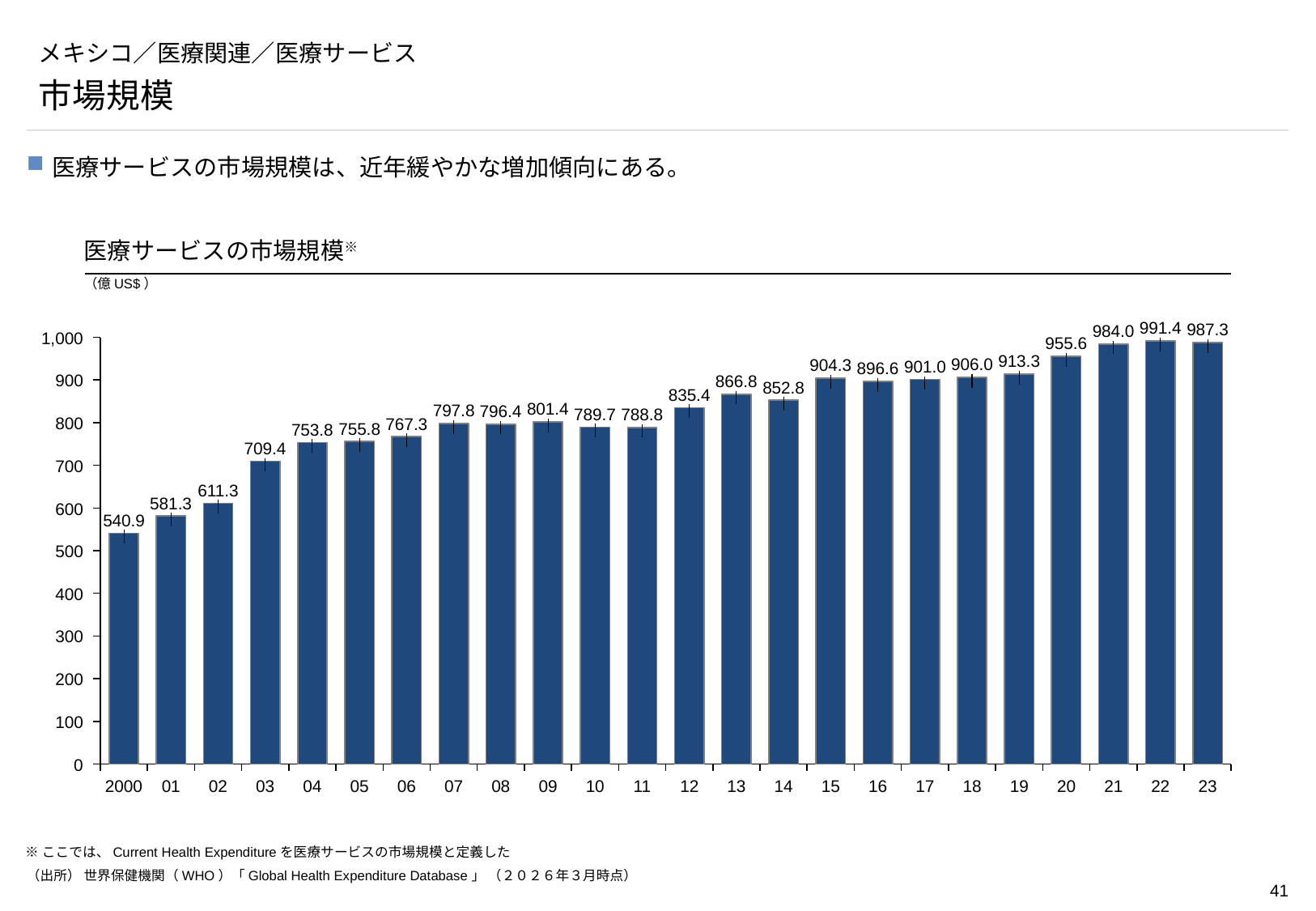
What is the difference between the values for 23 and 2000? 446.4 What is the value for 2015 in the chart? 904.3 Which is larger, the value for 13 or the value for 14? 13 Do the values generally rise or fall from 2000 to 23? rise What is the value for 23 (2023) in the chart? 987.3 Is the value for 12 greater or less than 800? greater What is the value for 2000 in the chart? 540.9 What is the difference between the values for 22 and 21? 7.4 Which year has the highest value in the chart? 22 How many years (bars) are shown in the chart? 24 Which year has the lowest value in the chart? 2000 What kind of chart is shown on the slide? bar chart